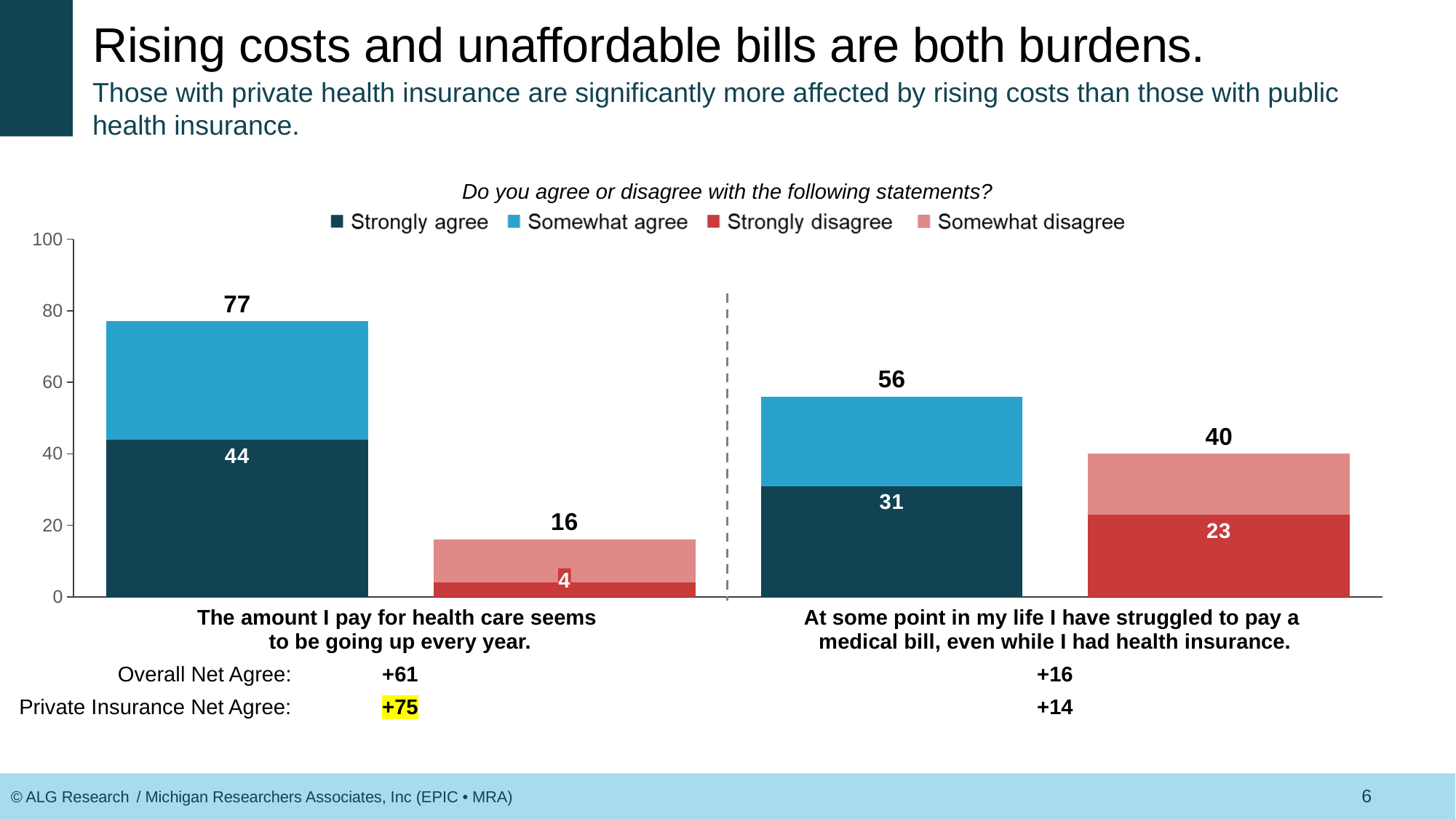
What is the Somewhat agree value for the statement "The amount I pay for health care seems to be going up every year." (total agree minus Strongly agree)? 33 What is the total disagree value for the statement "At some point in my life I have struggled to pay a medical bill, even while I had health insurance."? 40 What is the Strongly agree value for the statement "At some point in my life I have struggled to pay a medical bill, even while I had health insurance."? 31 Which statement has the higher total disagree value? At some point in my life I have struggled to pay a medical bill, even while I had health insurance. How many series does the legend list? 4 How much larger is the total agree value for the health care costs statement (77) than for the medical bill statement (56)? 21 What kind of chart is shown on the slide? Stacked bar chart What is the Strongly disagree value for the statement "The amount I pay for health care seems to be going up every year."? 4 Which statement has the higher Strongly agree value? The amount I pay for health care seems to be going up every year. What is the total agree value for the statement "The amount I pay for health care seems to be going up every year."? 77 What is the Private Insurance Net Agree value shown for the statement "The amount I pay for health care seems to be going up every year."? +75 What is the Somewhat disagree value for the statement "At some point in my life I have struggled to pay a medical bill, even while I had health insurance." (total disagree minus Strongly disagree)? 17